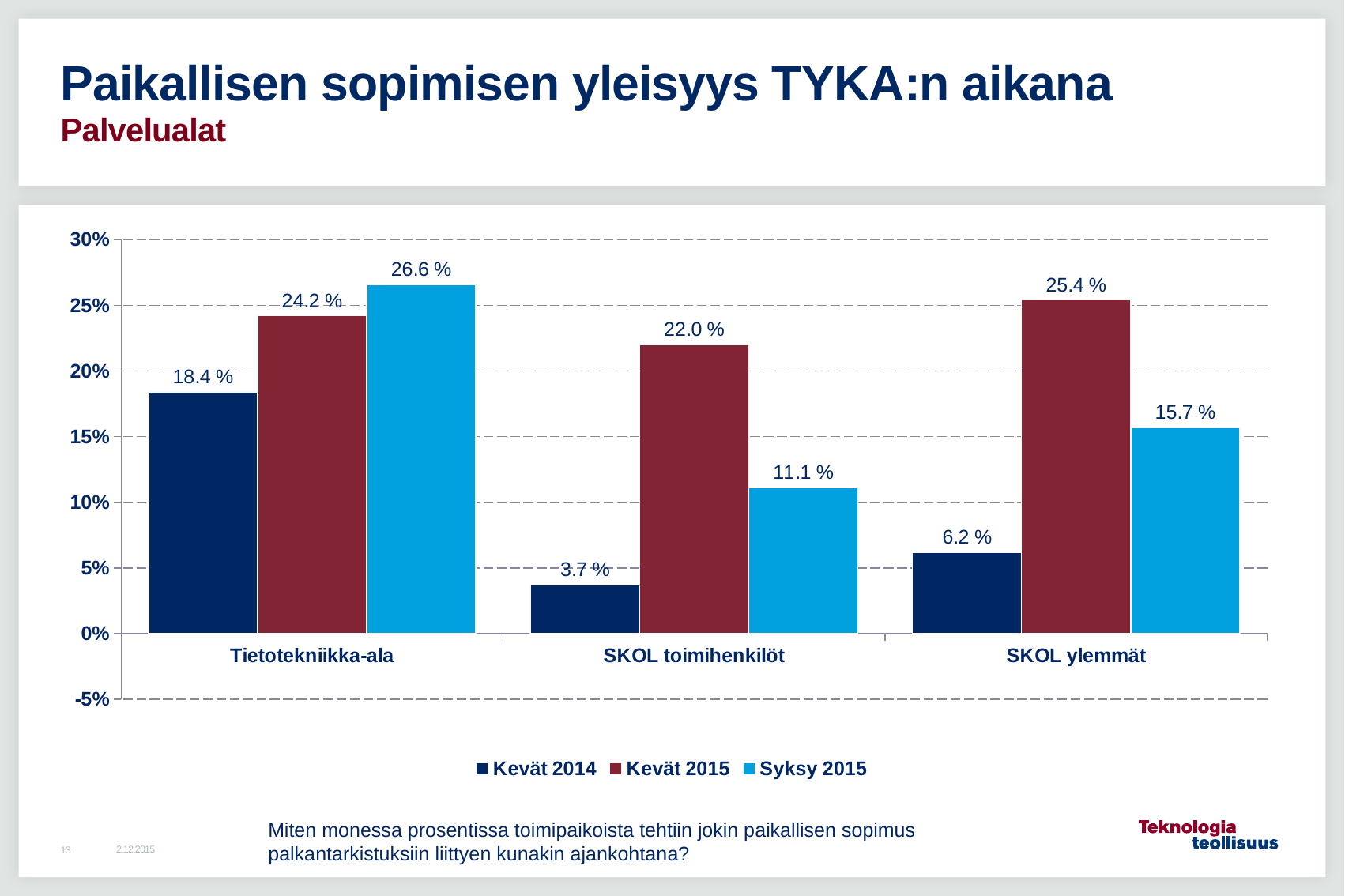
Which is larger for SKOL ylemmät: the Kevät 2015 value or the Syksy 2015 value? Kevät 2015 Which category has the highest value in the Kevät 2014 series? Tietotekniikka-ala What kind of chart is shown on the slide? bar chart What is the value for SKOL ylemmät in the Kevät 2015 series? 25.4 % What is the value for SKOL toimihenkilöt in the Kevät 2014 series? 3.7 % What is the difference between the Kevät 2015 and Kevät 2014 values for SKOL toimihenkilöt? 18.3 % Which series is shown in light blue in the legend? Syksy 2015 How many categories are shown on the x axis? 3 What is the value for Tietotekniikka-ala in the Syksy 2015 series? 26.6 % How many series does the legend list? 3 Which category has the lowest value in the Syksy 2015 series? SKOL toimihenkilöt Is the Syksy 2015 value for SKOL toimihenkilöt greater or less than 15%? less